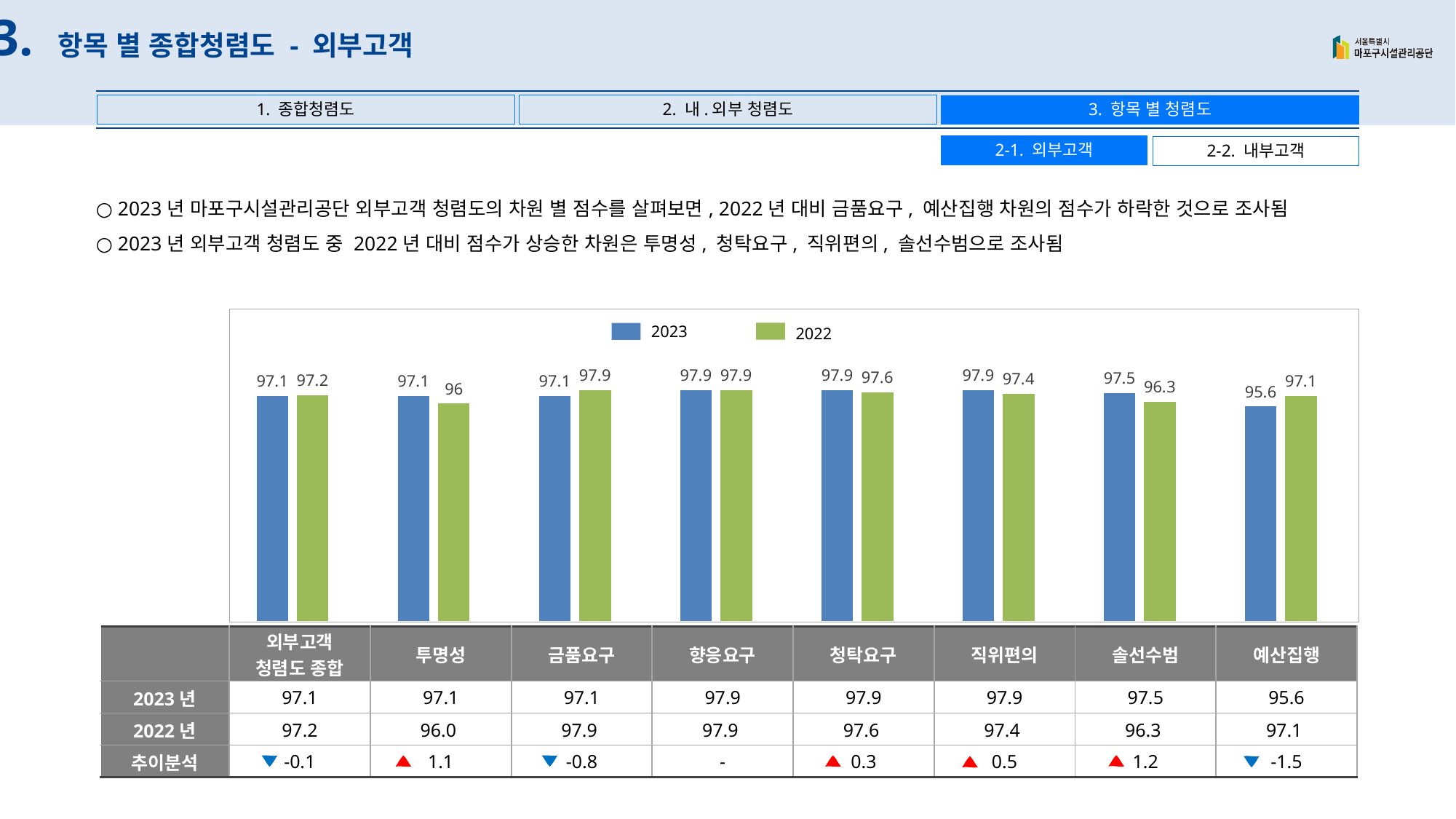
Which category has the lowest 2023 value? 예산집행 What is the difference between the 2023 and 2022 values for 솔선수범? 1.2 What is the 2022 value for 직위편의? 97.4 What is the 2022 value for 솔선수범? 96.3 For 금품요구, which series has the larger value, 2023 or 2022? 2022 How many categories are shown on the x axis of the chart? 8 What kind of chart is shown on the slide? Bar chart What is the 2023 value for 청탁요구? 97.9 Which category has the lowest 2022 value? 투명성 What is the difference between the 2022 and 2023 values for 예산집행? 1.5 How many series does the chart legend list? 2 What is the 2023 value for 예산집행? 95.6